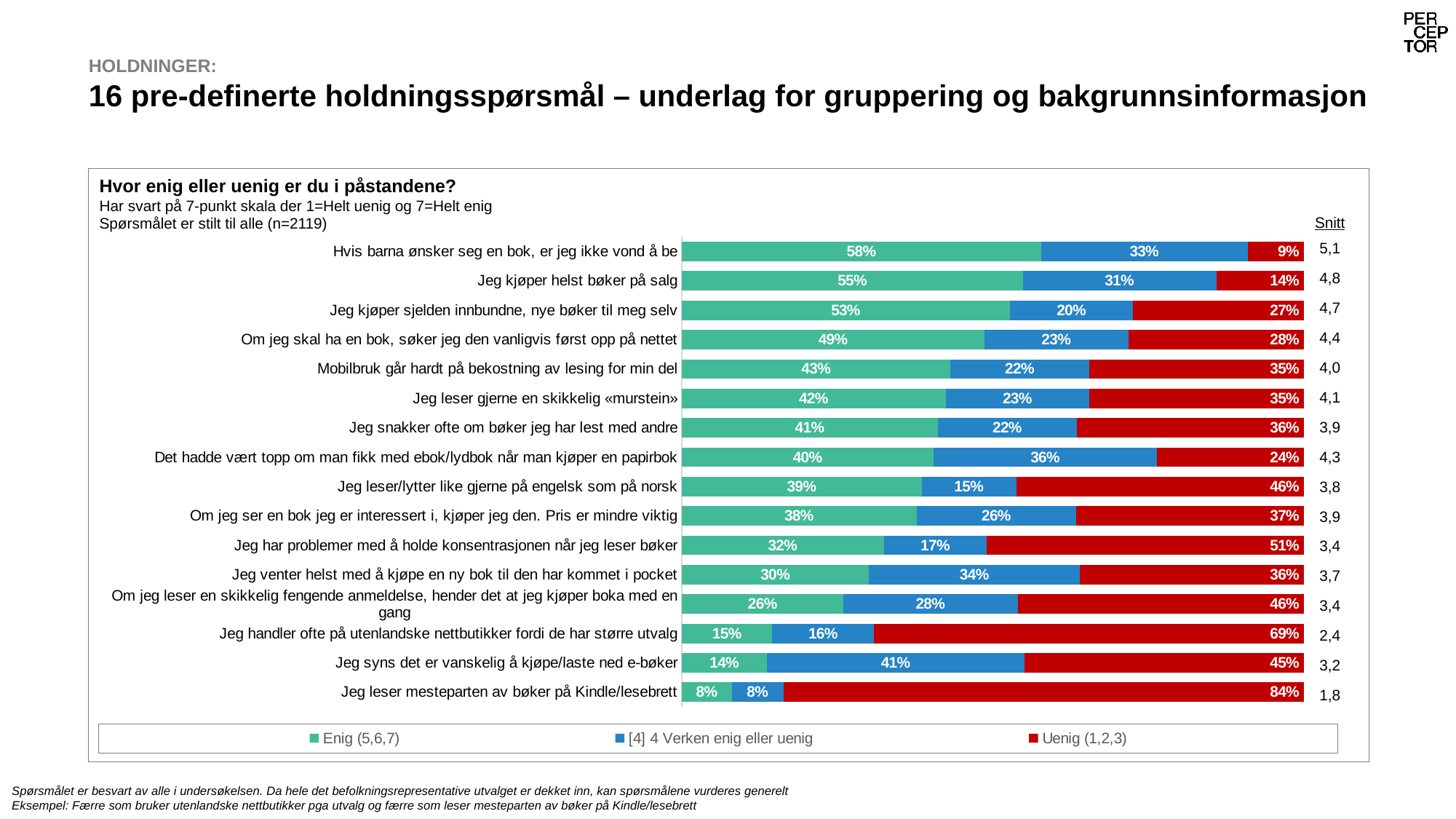
What percentage agree (Enig) with "Jeg kjøper helst bøker på salg"? 55% How many series does the legend list? 3 Which statement has the highest Enig (agree) percentage? Hvis barna ønsker seg en bok, er jeg ikke vond å be What is the neutral (Verken enig eller uenig) share for "Jeg syns det er vanskelig å kjøpe/laste ned e-bøker"? 41% Which statement has the lowest Uenig (disagree) percentage? Hvis barna ønsker seg en bok, er jeg ikke vond å be What type of chart is shown on the slide? Stacked bar chart Which is larger for "Jeg venter helst med å kjøpe en ny bok til den har kommet i pocket": the Enig share or the Uenig share? Uenig What percentage disagree (Uenig) with "Jeg leser mesteparten av bøker på Kindle/lesebrett"? 84% What is the difference between the Enig and Uenig percentages for "Jeg handler ofte på utenlandske nettbutikker fordi de har større utvalg"? 54% How many statements are shown in the chart? 16 Which colour represents the Uenig (1,2,3) series in the chart? Red What is the Snitt (average) value shown for "Mobilbruk går hardt på bekostning av lesing for min del"? 4,0